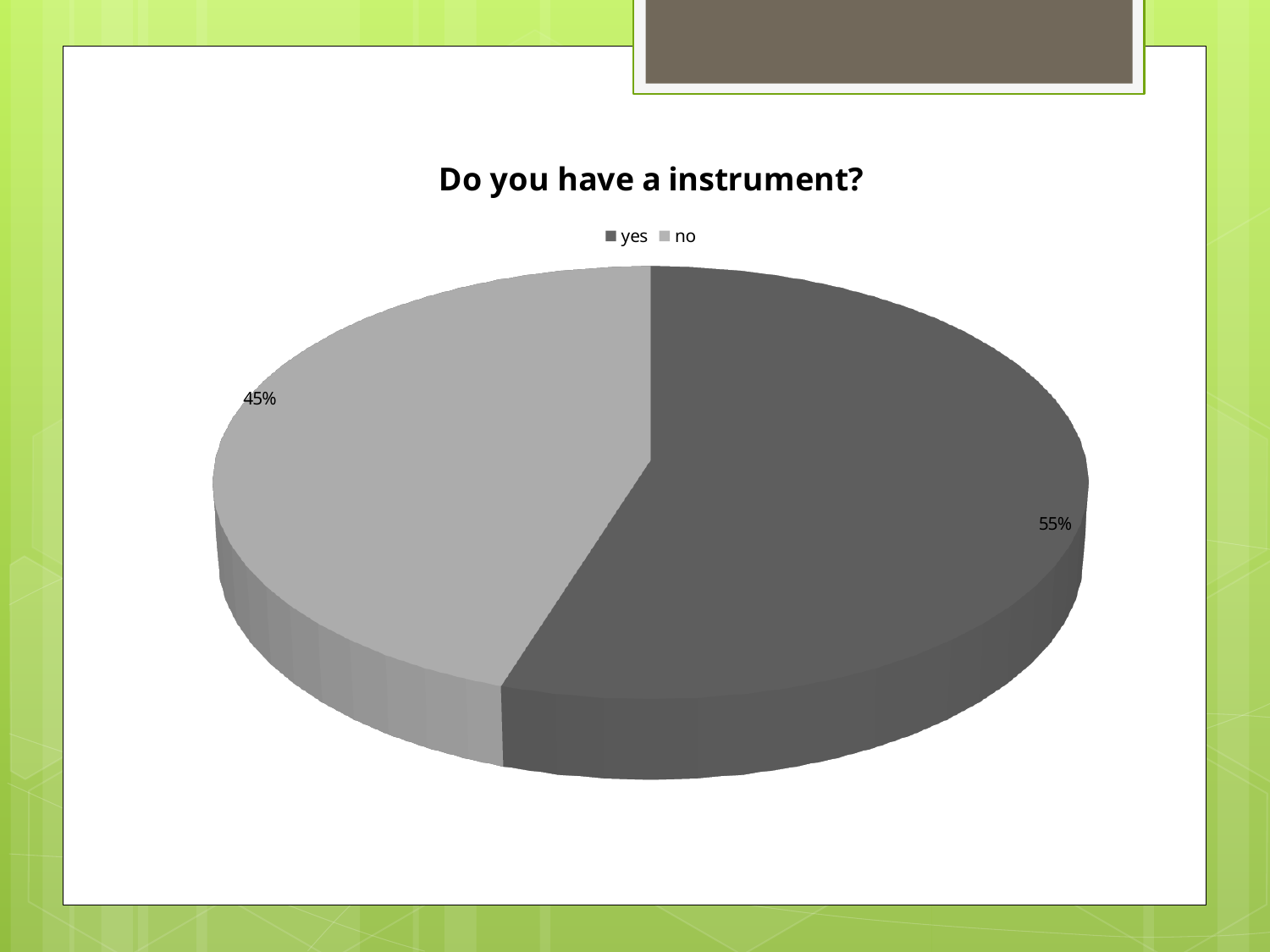
What is the difference in percentage points between the "yes" and "no" slices? 10 How many slices does the pie chart have? 2 What percentage of respondents answered "no"? 45% What is the title of the chart? Do you have a instrument? How many entries does the legend list? 2 Which legend entry is shown in the darker grey colour? yes What percentage of respondents answered "yes" to "Do you have a instrument?" 55% Which response has the larger share of the pie? yes What share of the pie does the "no" slice represent? 45% What kind of chart is shown on the slide? pie chart Is the share for "yes" larger or smaller than the share for "no"? larger Which response has the smaller share of the pie? no